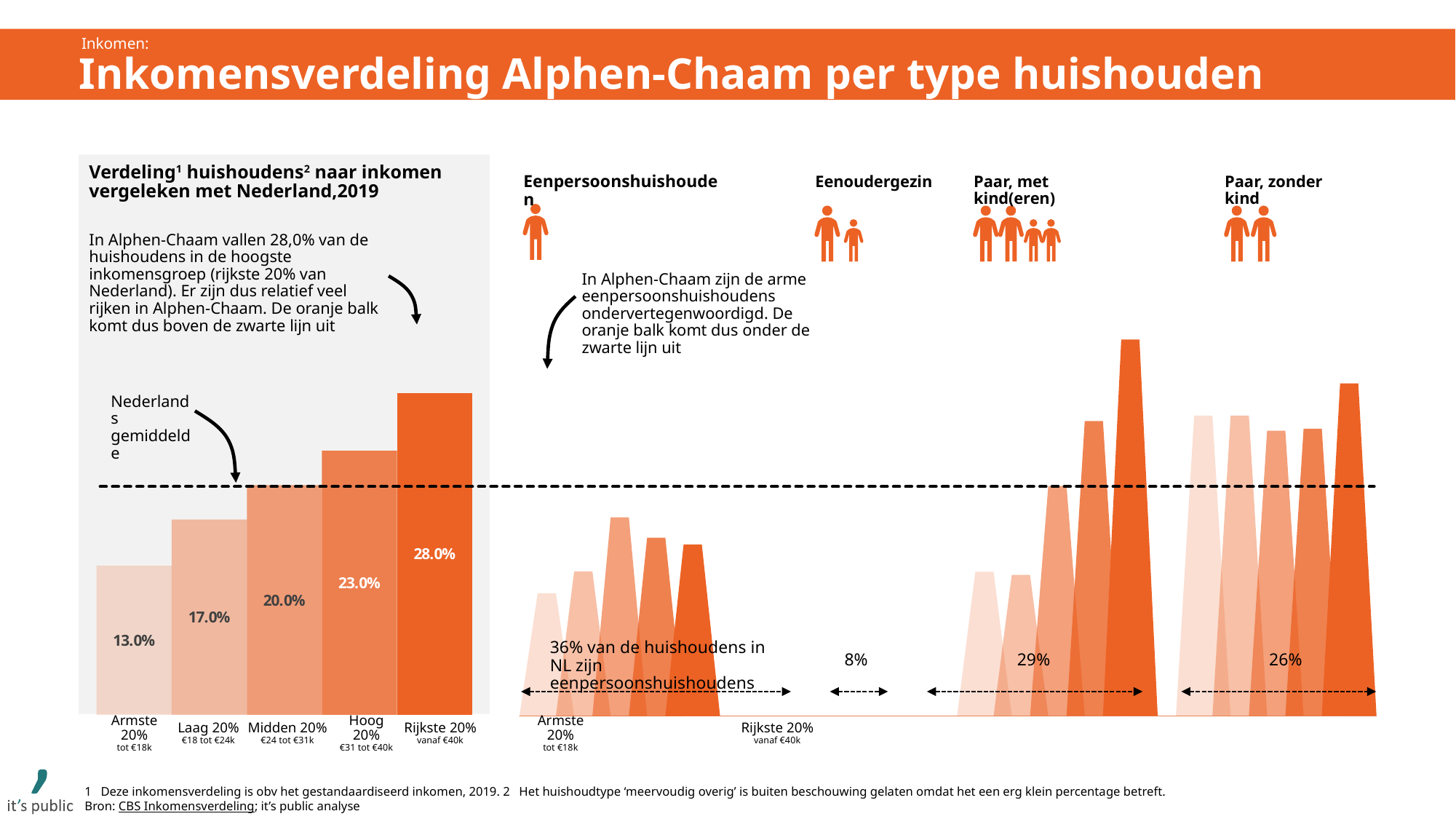
In the left chart 'Verdeling huishoudens naar inkomen vergeleken met Nederland, 2019', what is the value for Rijkste 20%? 28.0% In the left chart 'Verdeling huishoudens naar inkomen vergeleken met Nederland, 2019', what is the value for Midden 20%? 20.0% In the left chart 'Verdeling huishoudens naar inkomen vergeleken met Nederland, 2019', which income group has the highest value? Rijkste 20% In the left chart 'Verdeling huishoudens naar inkomen vergeleken met Nederland, 2019', do the values rise or fall from Armste 20% to Rijkste 20%? rise In the left chart 'Verdeling huishoudens naar inkomen vergeleken met Nederland, 2019', what is the value for Armste 20%? 13.0% In the left chart 'Verdeling huishoudens naar inkomen vergeleken met Nederland, 2019', which is larger: the value for Laag 20% or the value for Hoog 20%? Hoog 20% In the left chart 'Verdeling huishoudens naar inkomen vergeleken met Nederland, 2019', what is the difference between the values for Hoog 20% and Laag 20%? 6.0% What kind of chart is the left chart 'Verdeling huishoudens naar inkomen vergeleken met Nederland, 2019'? bar chart In the left chart 'Verdeling huishoudens naar inkomen vergeleken met Nederland, 2019', what is the difference between the values for Rijkste 20% and Armste 20%? 15.0% In the right chart, what percentage of households in NL are Eenoudergezin according to the label? 8% In the left chart 'Verdeling huishoudens naar inkomen vergeleken met Nederland, 2019', how many income groups are shown? 5 In the left chart 'Verdeling huishoudens naar inkomen vergeleken met Nederland, 2019', which income group has the lowest value? Armste 20%